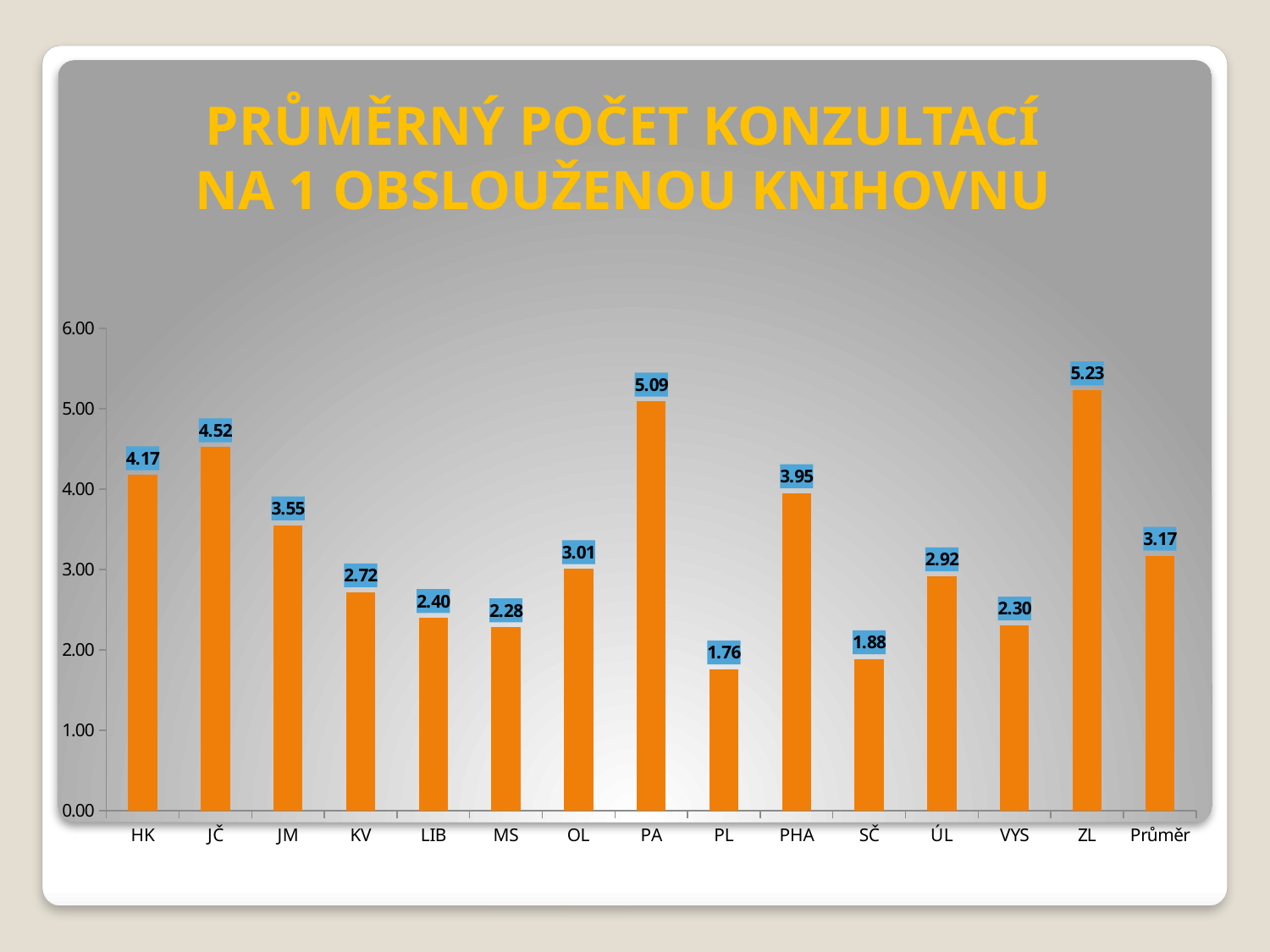
How many bars are shown in the chart? 15 Which is larger, the value for JČ or the value for PHA? JČ What is the value for LIB? 2.40 What is the title of the chart? PRŮMĚRNÝ POČET KONZULTACÍ NA 1 OBSLOUŽENOU KNIHOVNU What is the difference between the values for ZL and PL? 3.47 What is the value for Průměr? 3.17 What is the value for PA? 5.09 What is the difference between the values for Průměr and SČ? 1.29 Which category has the lowest value? PL Which category has the highest value? ZL Is the value for HK greater or less than 4.00? greater What kind of chart is shown on the slide? bar chart